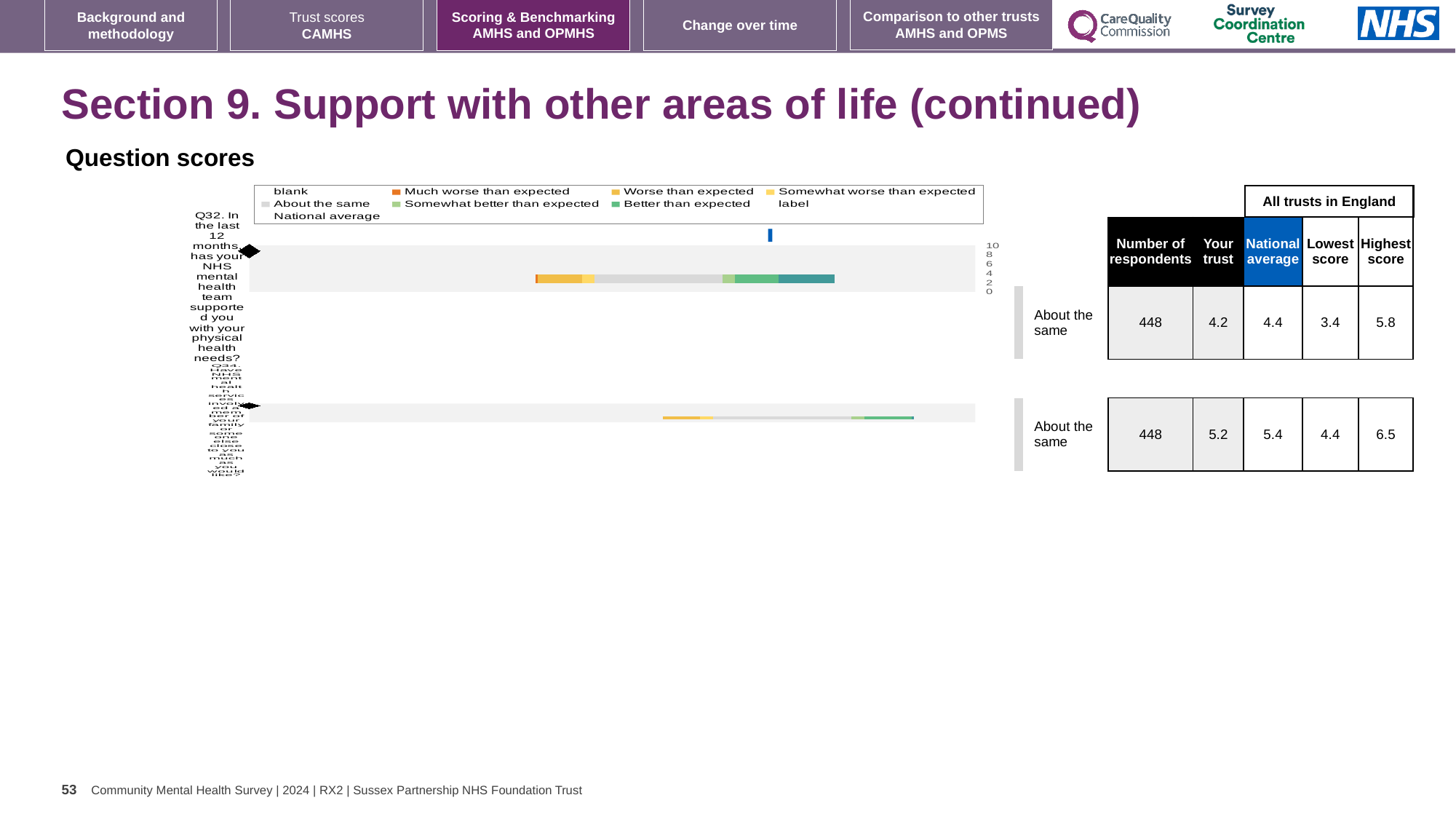
How many questions (bars) are plotted in the chart? 2 In the table, what is the lowest score for Q32? 3.4 What is the highest value shown on the chart's numeric axis? 10 What benchmark category is shown for Q32 (support with physical health needs)? About the same In the chart legend, what colour represents 'Much worse than expected'? orange In the table, what is the national average for Q32? 4.4 In the table, what is the highest score for Q34? 6.5 What is the difference between the highest score and the lowest score for Q34? 2.1 For Q34, which is larger: the 'Your trust' score or the national average? National average In the table, what is the number of respondents for Q32? 448 In the table, what is the 'Your trust' score for Q32? 4.2 What type of chart is used to show the question scores? bar chart